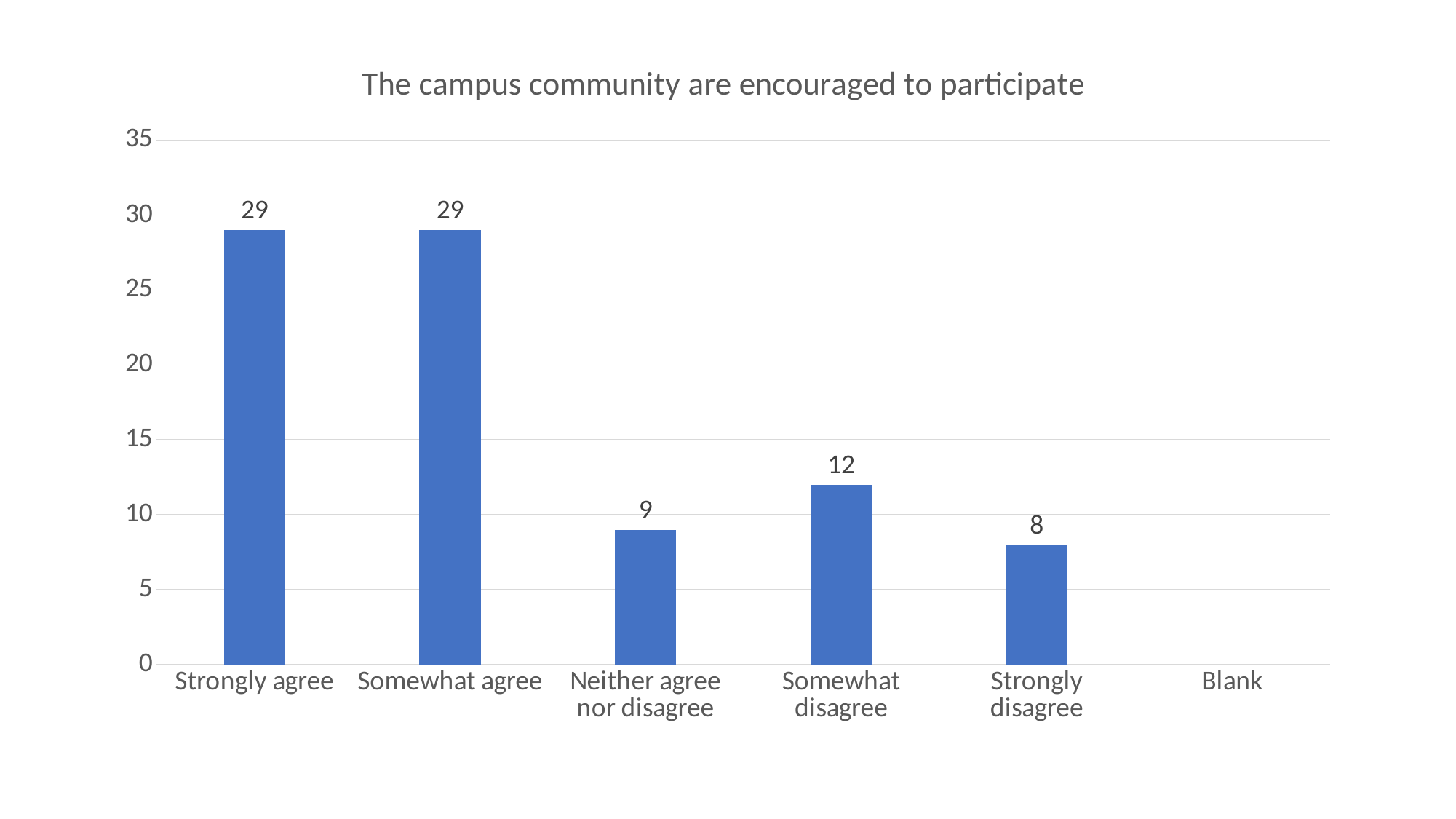
What kind of chart is this? Bar chart How many categories are shown on the x axis? 6 What is the value for Strongly agree? 29 What is the value for Somewhat agree? 29 Which category has the lowest value among those with a visible bar? Strongly disagree What is the difference between the values for Somewhat agree and Somewhat disagree? 17 What is the value for Strongly disagree? 8 What is the difference between the values for Somewhat disagree and Strongly disagree? 4 What is the value for Neither agree nor disagree? 9 What is the value for Somewhat disagree? 12 Which is larger, the value for Neither agree nor disagree or the value for Somewhat disagree? Somewhat disagree What is the title of the chart? The campus community are encouraged to participate